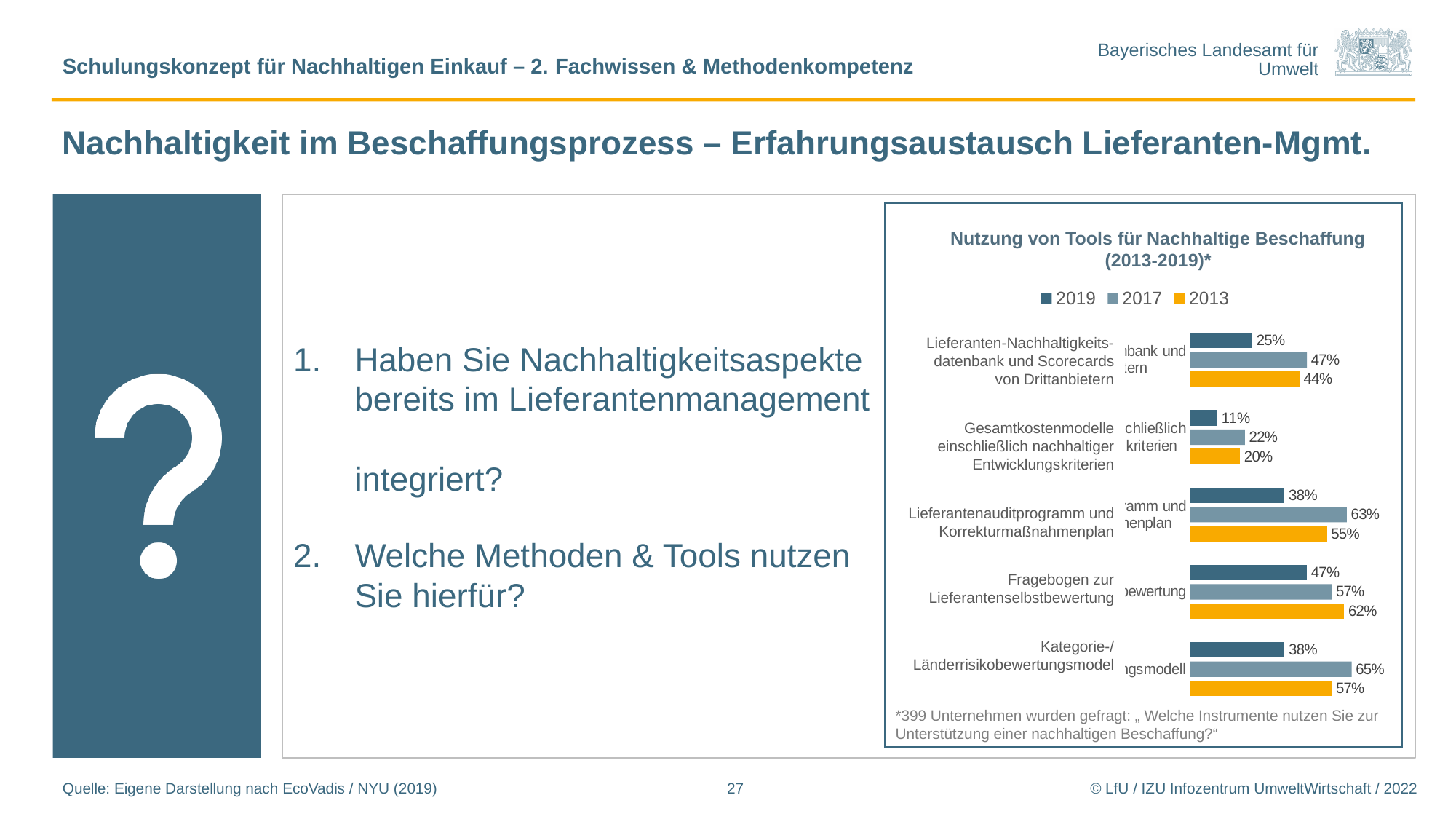
What is the 2017 value for 'Gesamtkostenmodelle einschließlich nachhaltiger Entwicklungskriterien'? 22% How many categories (tools) are shown in the chart? 5 What is the 2013 value for 'Lieferantenauditprogramm und Korrekturmaßnahmenplan'? 55% What is the 2019 value for 'Fragebogen zur Lieferantenselbstbewertung'? 47% For 'Fragebogen zur Lieferantenselbstbewertung', which year has the larger value, 2013 or 2017? 2013 What is the difference between the 2017 and 2019 values for 'Kategorie-/Länderrisikobewertungsmodell'? 27% How many series does the chart legend list? 3 What kind of chart is shown on the slide? Bar chart What is the difference between the 2017 and 2013 values for 'Lieferanten-Nachhaltigkeitsdatenbank und Scorecards von Drittanbietern'? 3% Which colour represents the 2013 series in the chart? Orange/yellow Which category has the highest 2017 value? Kategorie-/Länderrisikobewertungsmodell Which category has the lowest 2019 value? Gesamtkostenmodelle einschließlich nachhaltiger Entwicklungskriterien